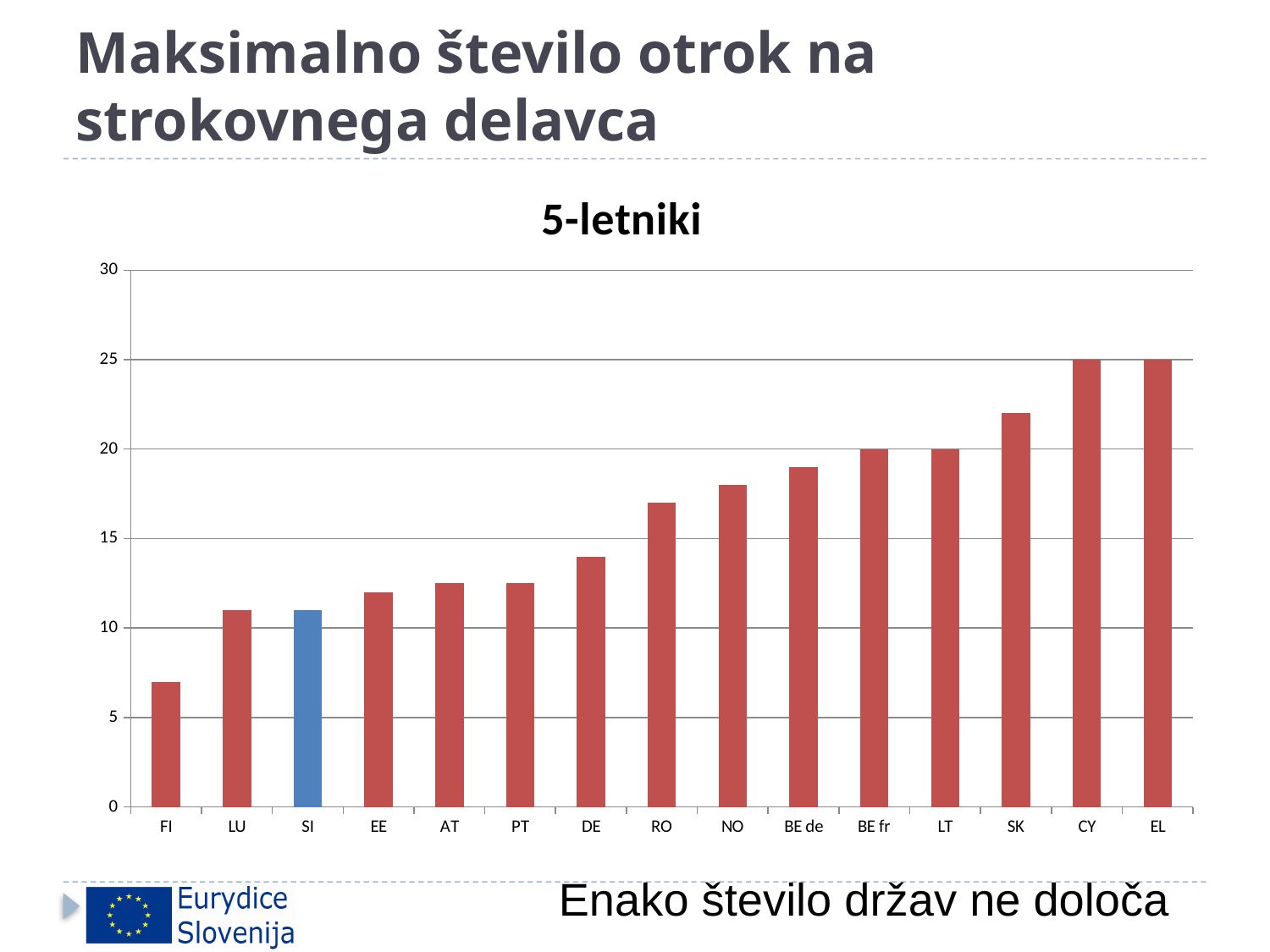
What is the title of the chart? 5-letniki Is the value for DE greater or less than 15? less Is the value for FI greater or less than 10? less Do the values generally rise or fall from left to right along the x axis? rise Which is larger, the value for SK or the value for DE? SK Which country has the lowest value in the chart? FI What is the value for LT? 20 Is the value for SK greater or less than 20? greater What is the value for CY? 25 What is the value for BE fr? 20 What kind of chart is shown on the slide? bar chart How many countries are shown on the x axis of the chart? 15